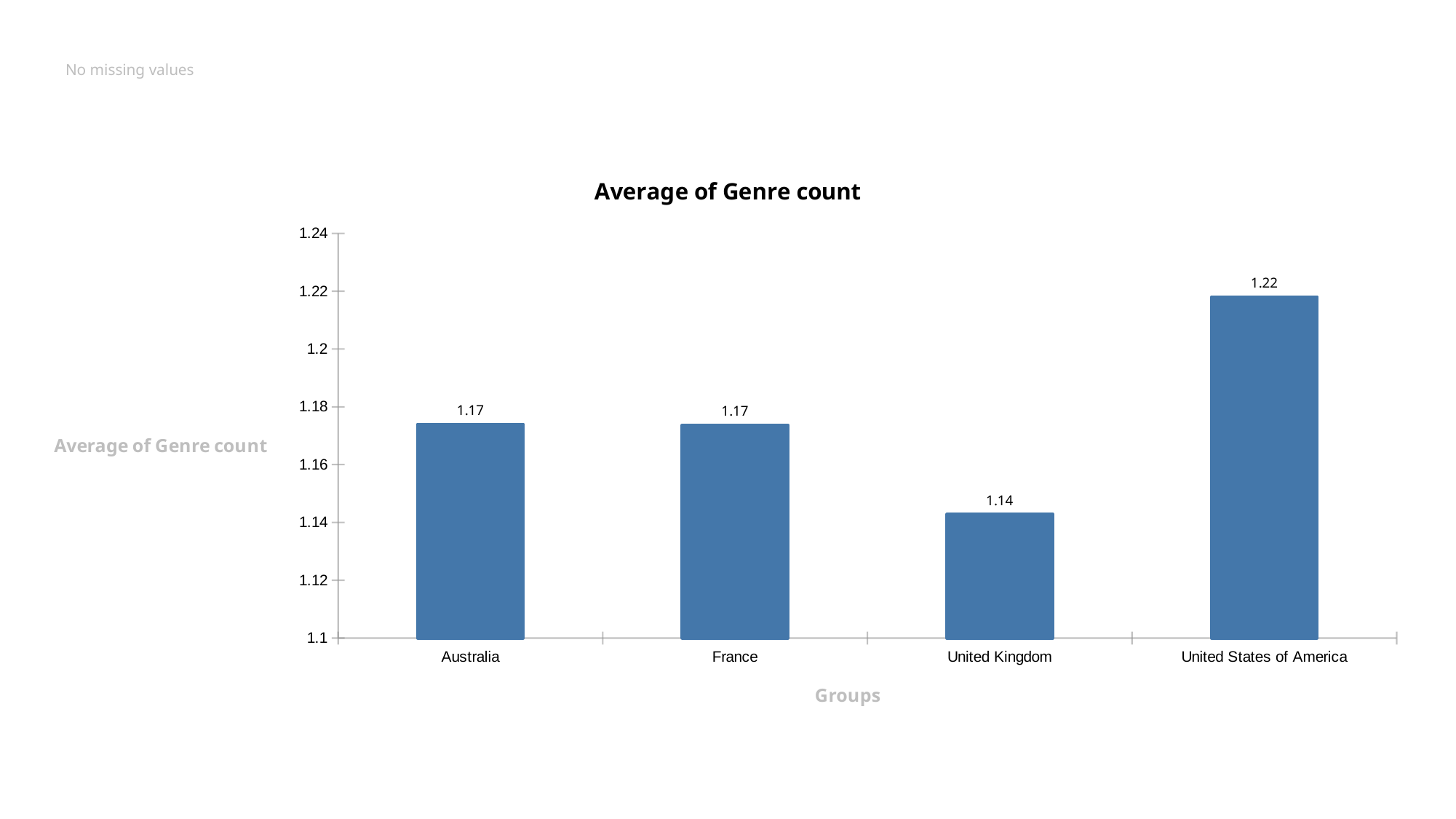
Is the value for the United States of America greater or less than 1.2? greater What is the average of Genre count for the United States of America? 1.22 What is the average of Genre count for the United Kingdom? 1.14 Which group has the highest average of Genre count? United States of America Which group has the lowest average of Genre count? United Kingdom What is the average of Genre count for Australia? 1.17 What kind of chart is shown on the slide? Bar chart What is the title of the chart? Average of Genre count How many groups are shown on the x axis? 4 What is the average of Genre count for France? 1.17 What is the difference between the average of Genre count for the United States of America and the United Kingdom? 0.08 Which has a larger average of Genre count, Australia or the United Kingdom? Australia